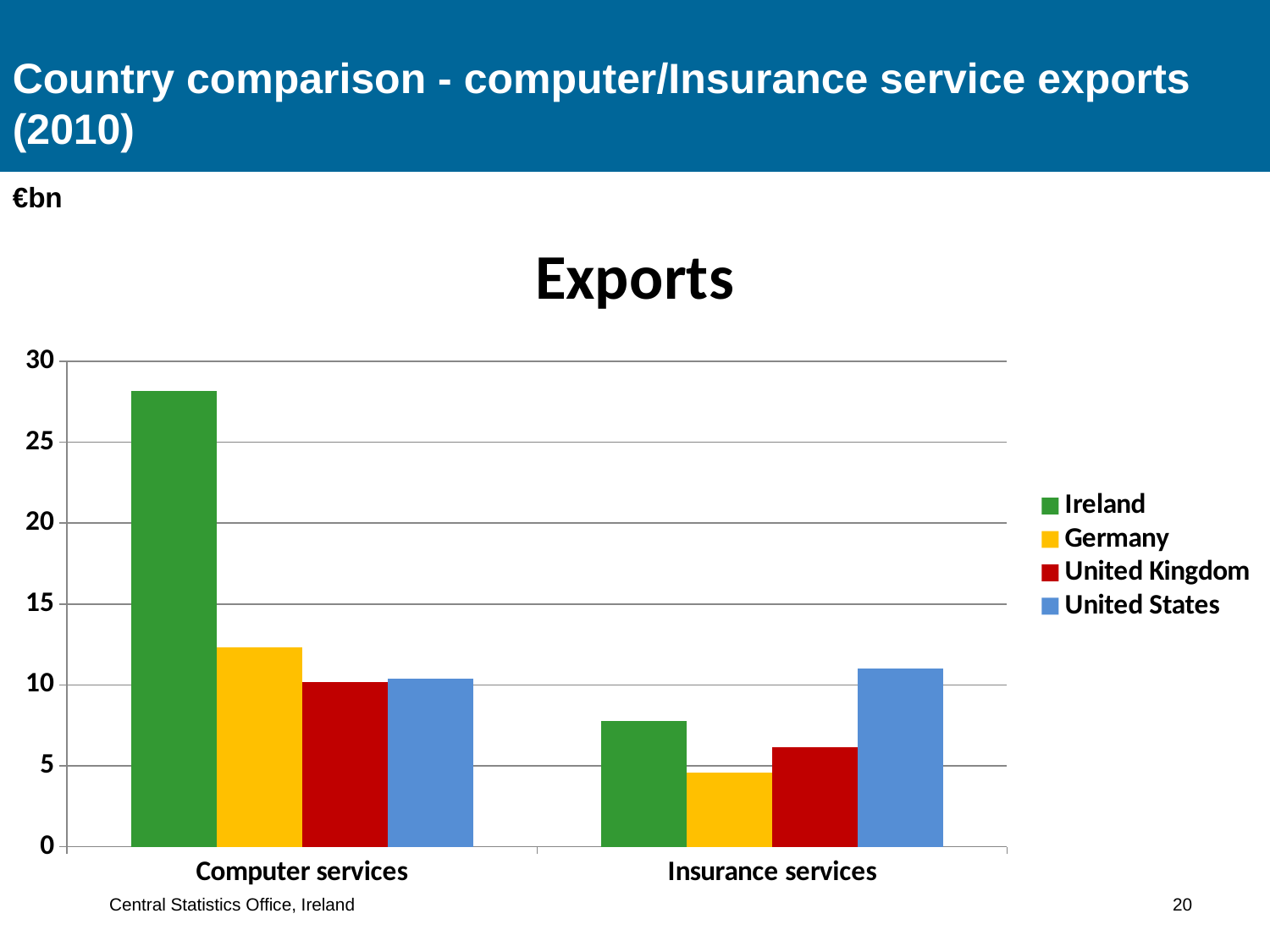
How many categories are shown on the x axis? 2 What is the title of the chart? Exports Which country has the highest exports for Insurance services? United States What kind of chart is shown on the slide? bar chart Is the value for Germany in Computer services greater or less than 10? greater Is the value for United States in Insurance services greater or less than 10? greater Is the value for Ireland in Insurance services greater or less than 10? less How many series does the legend list? 4 Which country has the highest exports for Computer services? Ireland Which country has the lowest exports for Insurance services? Germany Which is larger for Ireland: exports of Computer services or Insurance services? Computer services